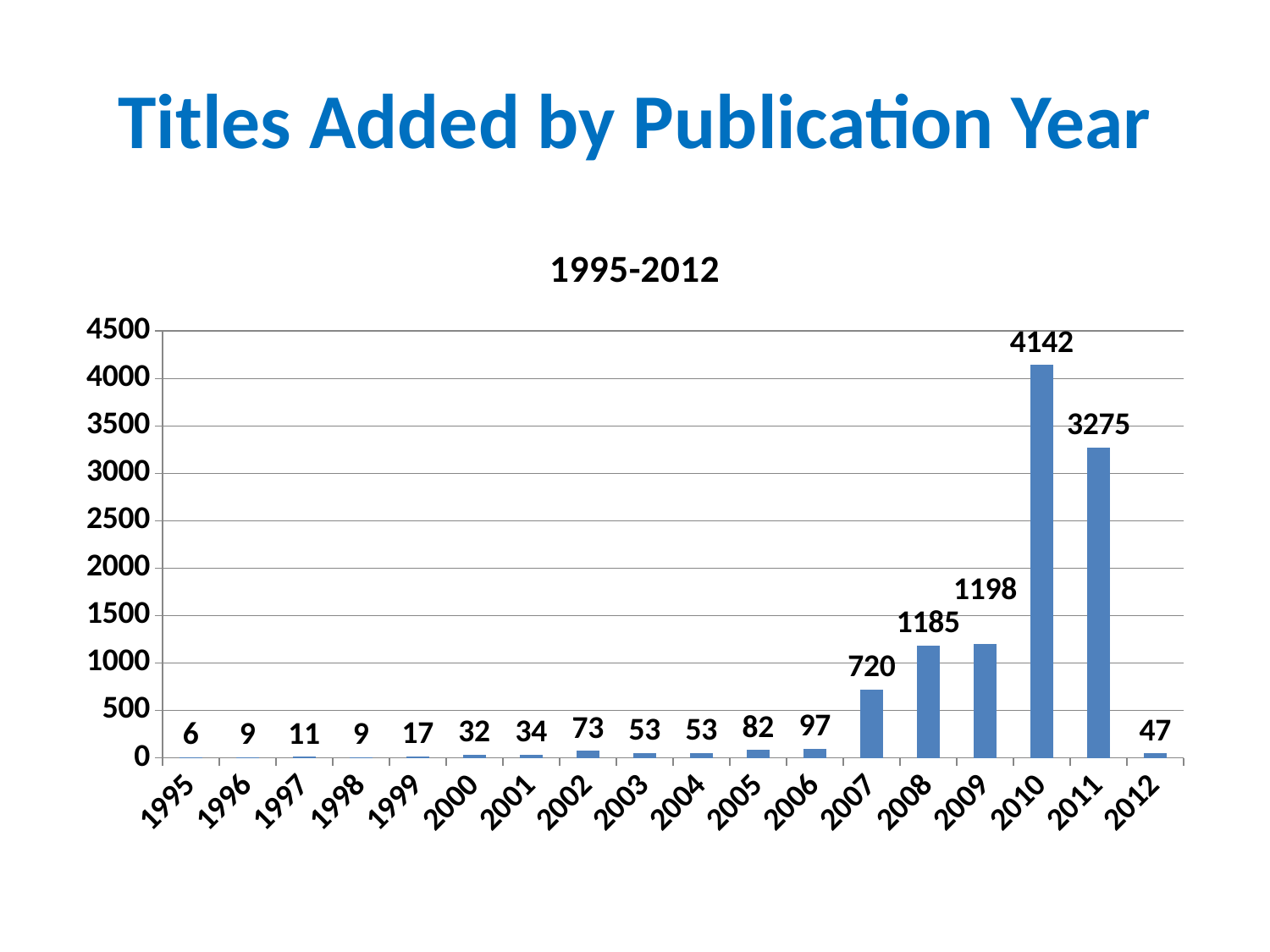
What is the difference between the values for 2010 and 2011? 867 How many years are shown on the x axis? 18 Which year has the highest value? 2010 Which is larger, the value for 2011 or the value for 2009? 2011 What is the value for 2010? 4142 Is the value for 2011 greater or less than 3000? greater What is the value for 2007? 720 What is the value for 2012? 47 What kind of chart is this? bar chart What is the difference between the values for 2009 and 2008? 13 What is the chart's title? 1995-2012 Which year has the lowest value? 1995